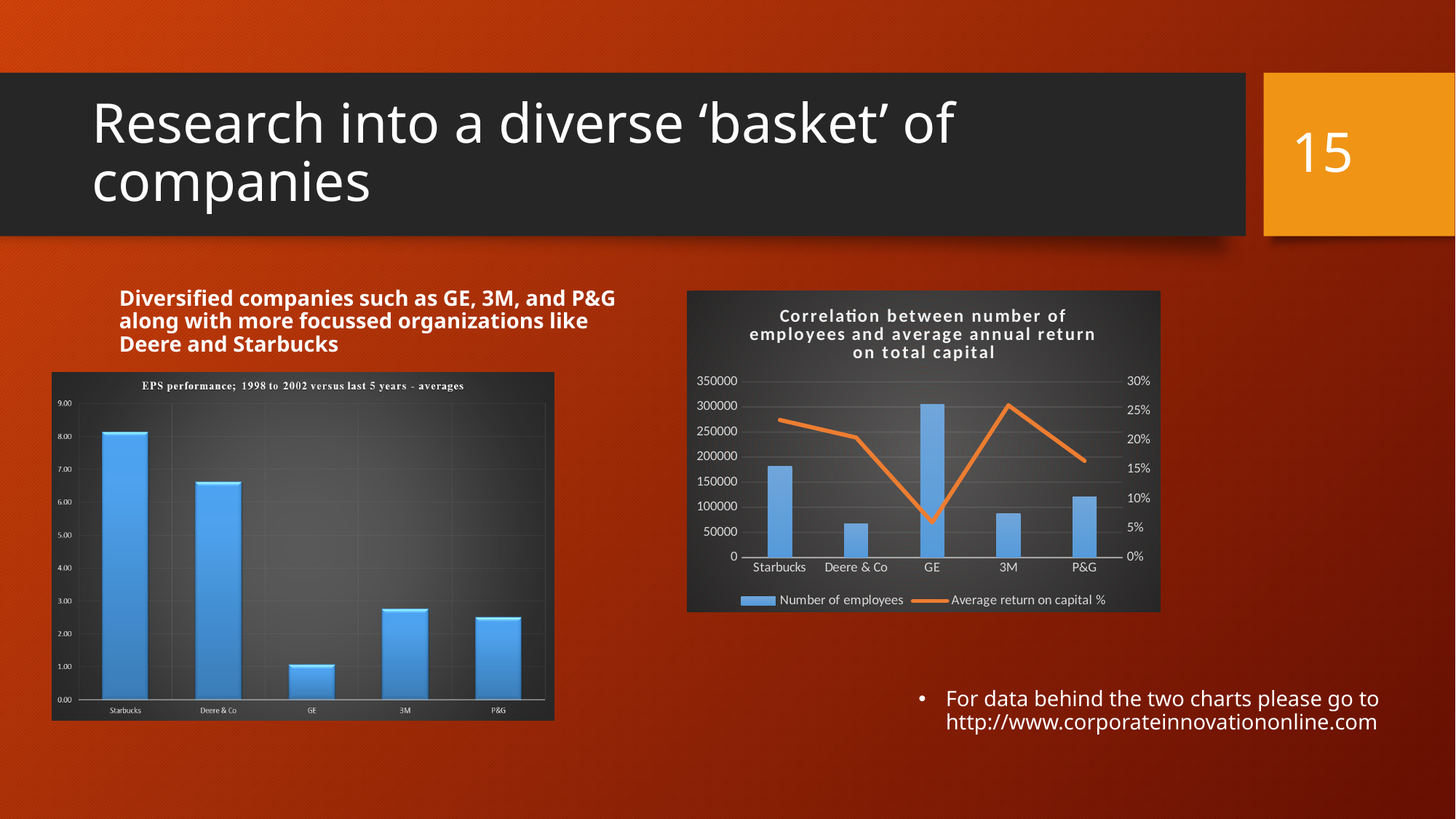
In the EPS performance chart on the left, is the value for Starbucks greater or less than 8.00? greater In the EPS performance chart on the left, is the value for Deere & Co greater or less than 6.00? greater In the EPS performance chart on the left, how many companies are shown on the x axis? 5 In the EPS performance chart on the left, which company has the lowest bar? GE In the EPS performance chart on the left, which company has the highest bar? Starbucks What kind of chart is the EPS performance chart on the left? Bar chart In the 'Correlation between number of employees and average annual return on total capital' chart, which company has the lowest average return on capital %? GE In the 'Correlation between number of employees and average annual return on total capital' chart, which company has the highest number of employees? GE In the 'Correlation between number of employees and average annual return on total capital' chart, which company has the lowest number of employees? Deere & Co In the 'Correlation between number of employees and average annual return on total capital' chart, how many series does the legend list? 2 In the 'Correlation between number of employees and average annual return on total capital' chart, which series is drawn as an orange line? Average return on capital %